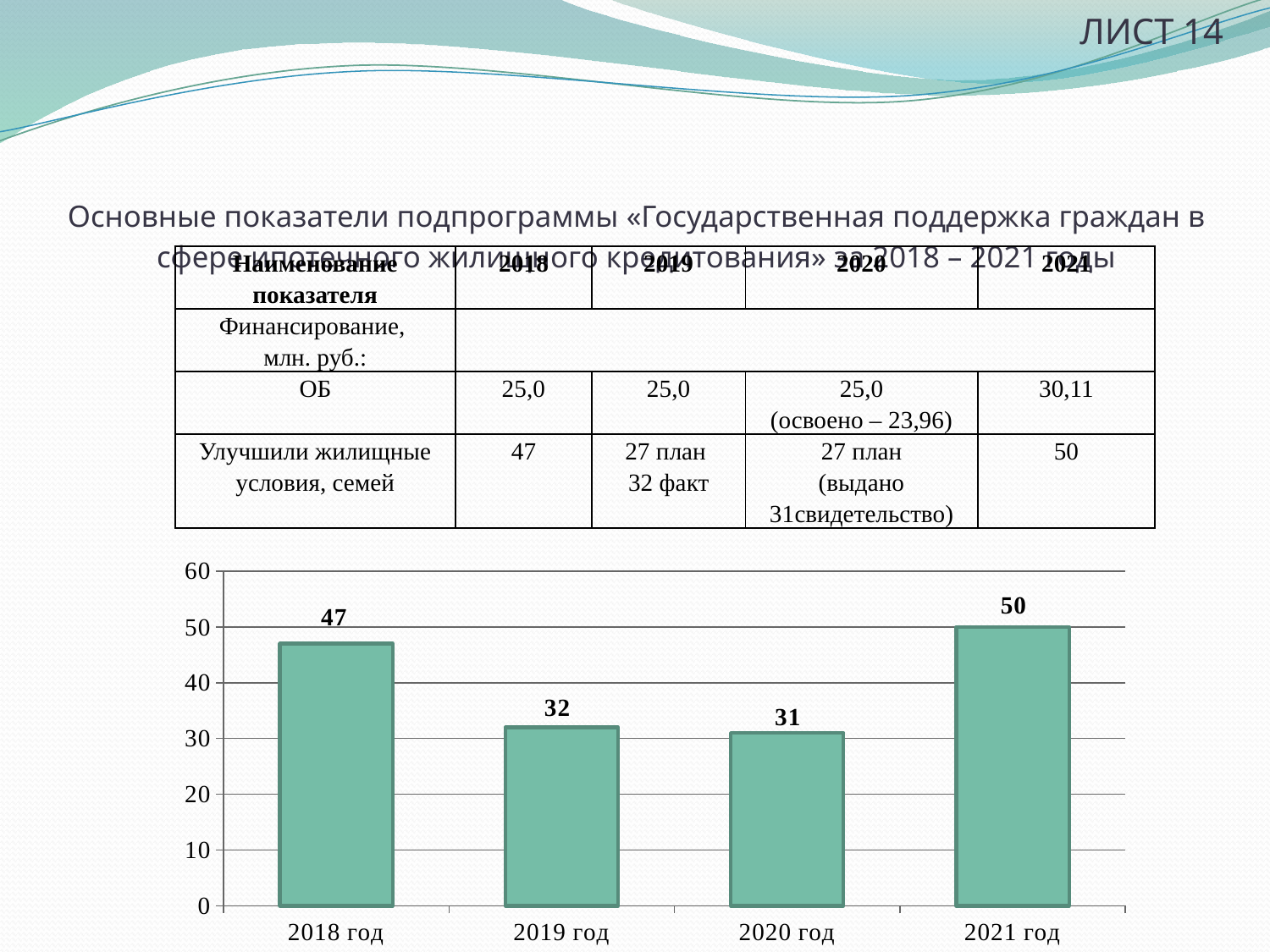
What is the difference between the values for 2018 год and 2019 год in the bar chart? 15 What is the value for 2020 год in the bar chart? 31 What kind of chart is shown on the slide? bar chart What is the value for 2019 год in the bar chart? 32 How many bars are shown in the bar chart? 4 Which year has the lowest value in the bar chart? 2020 год Which year has the highest value in the bar chart? 2021 год Which is larger in the bar chart, the value for 2018 год or the value for 2020 год? 2018 год What is the difference between the values for 2021 год and 2018 год in the bar chart? 3 What is the value for 2021 год in the bar chart? 50 What is the value for 2018 год in the bar chart? 47 Is the value for 2021 год in the bar chart greater or less than 40? greater